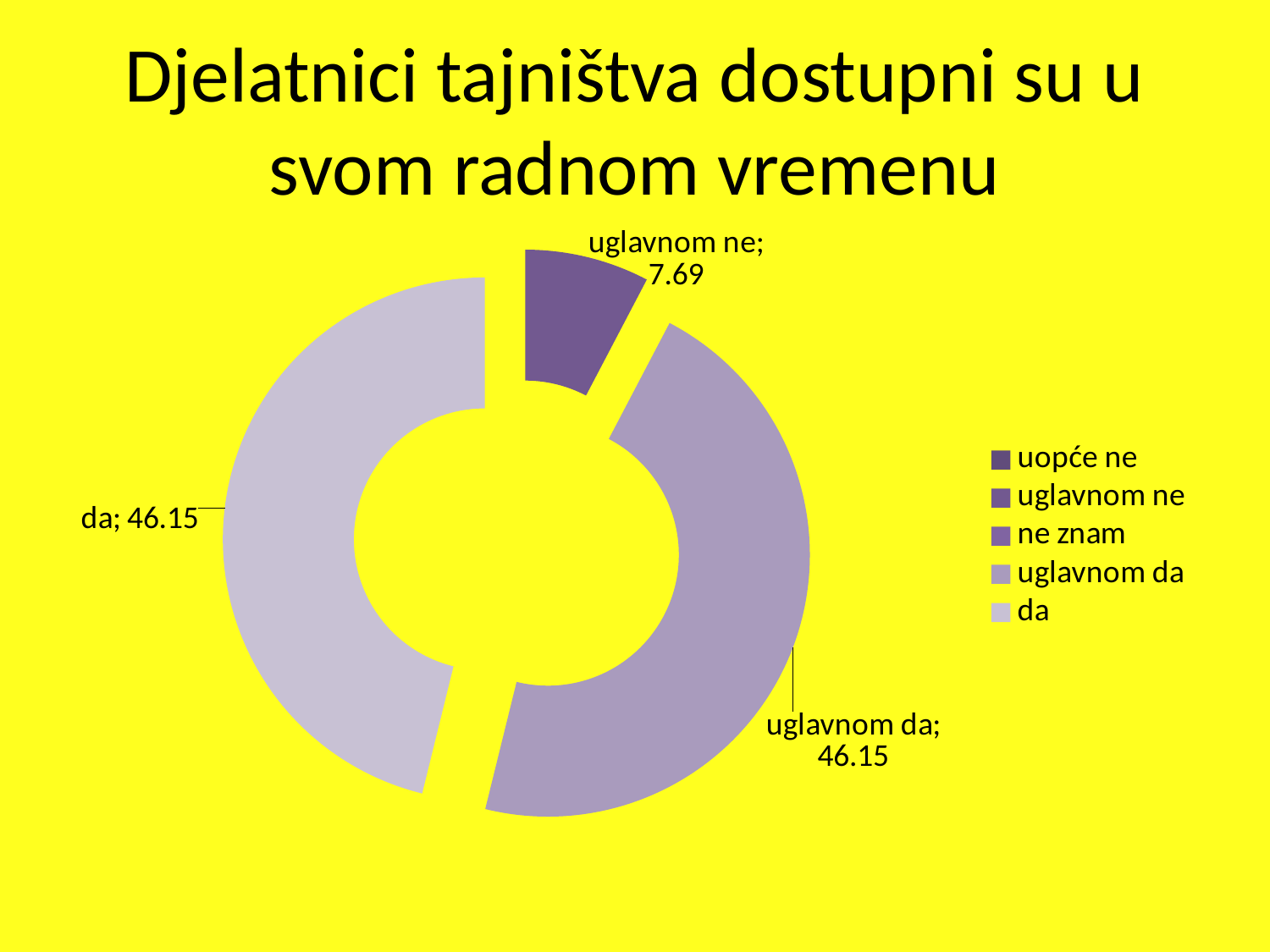
Which is larger, the value for "uglavnom da" or the value for "uglavnom ne"? uglavnom da What is the value shown for "uglavnom ne"? 7.69 What kind of chart is shown on the slide? Doughnut (pie) chart How many entries does the legend list? 5 Do "da" and "uglavnom da" have the same value? Yes What is the value shown for "uglavnom da"? 46.15 Which labelled slice has the smallest value? uglavnom ne What is the title of the chart? Djelatnici tajništva dostupni su u svom radnom vremenu Which legend entry is listed first? uopće ne How many slices with data labels are visible in the chart? 3 What is the difference between the value for "da" and the value for "uglavnom ne"? 38.46 What is the value shown for "da"? 46.15